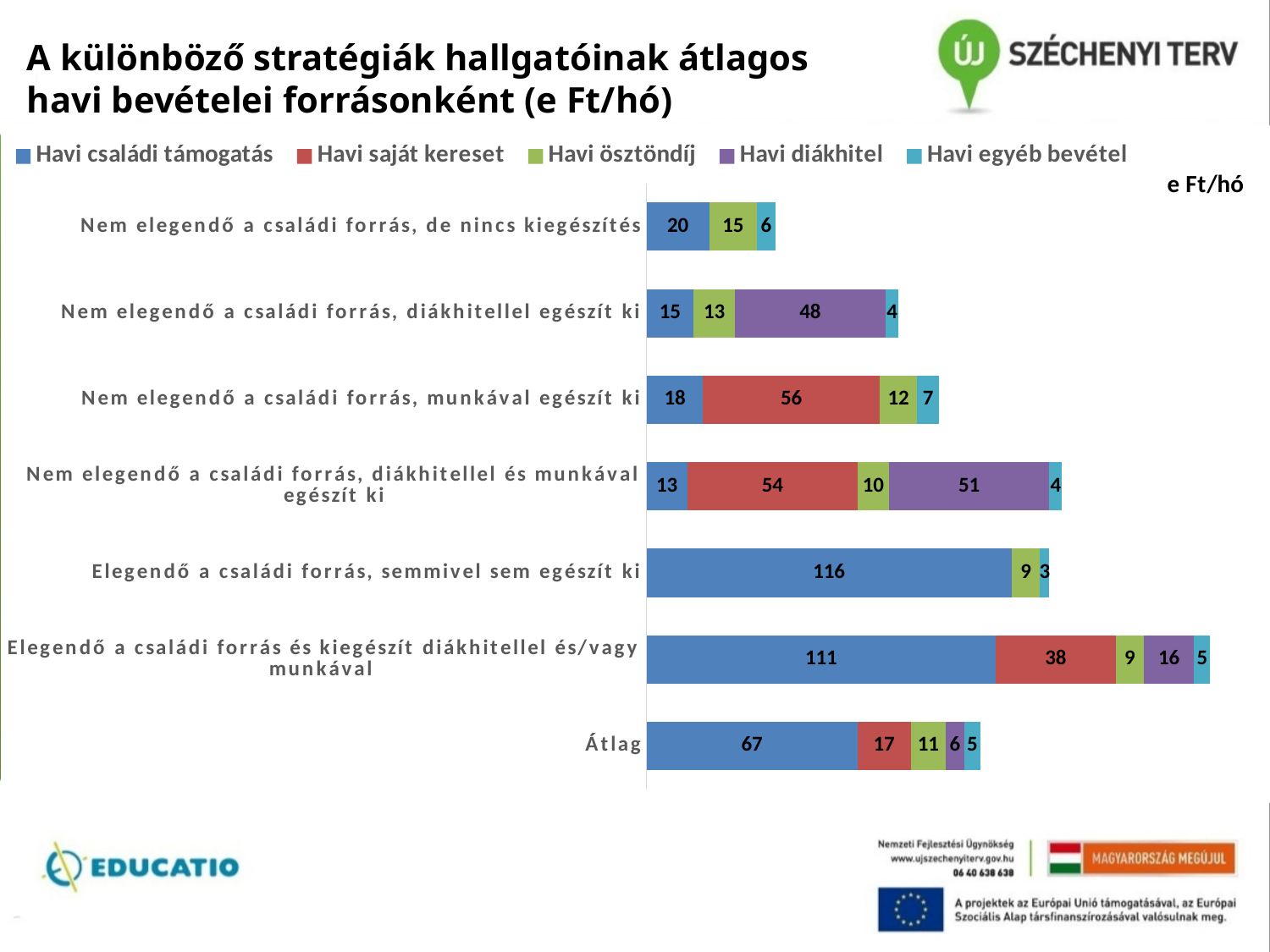
How many categories (bars) are plotted in the chart? 7 How many series does the legend list? 5 What is the total of the stacked bar for 'Átlag'? 106 What is the value of Havi diákhitel for 'Nem elegendő a családi forrás, diákhitellel egészít ki'? 48 What is the value of Havi saját kereset for 'Átlag'? 17 Which category has the lowest value for Havi családi támogatás? Nem elegendő a családi forrás, diákhitellel és munkával egészít ki What unit is shown above the chart? e Ft/hó What is the difference between Havi saját kereset for 'Nem elegendő a családi forrás, munkával egészít ki' and for 'Elegendő a családi forrás és kiegészít diákhitellel és/vagy munkával'? 18 Which is larger: Havi diákhitel for 'Nem elegendő a családi forrás, diákhitellel és munkával egészít ki' or for 'Elegendő a családi forrás és kiegészít diákhitellel és/vagy munkával'? Nem elegendő a családi forrás, diákhitellel és munkával egészít ki What kind of chart is shown on the slide? Stacked bar chart What is the value of Havi családi támogatás for 'Elegendő a családi forrás, semmivel sem egészít ki'? 116 Which category has the highest value for Havi családi támogatás? Elegendő a családi forrás, semmivel sem egészít ki